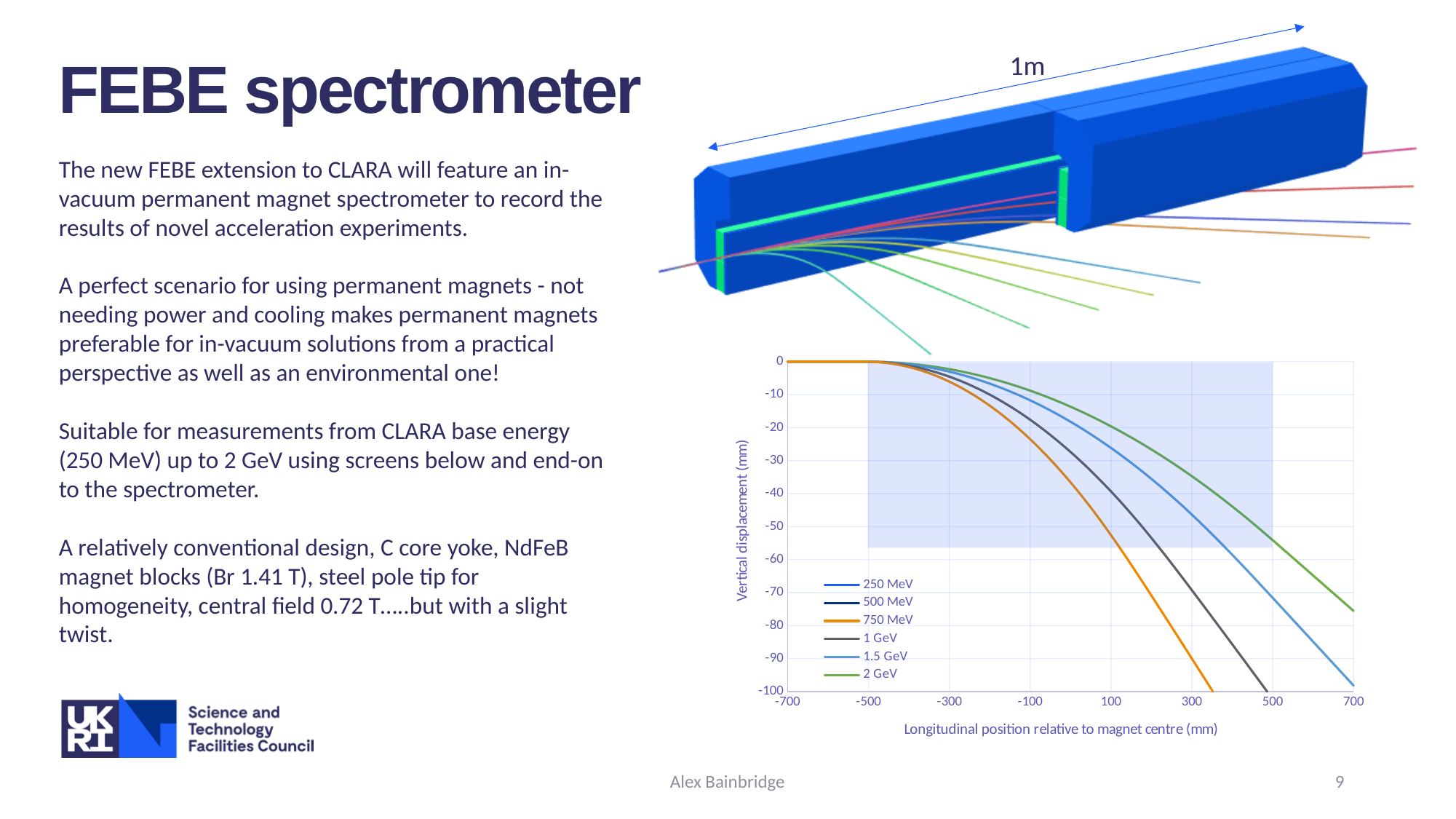
Which curve reaches a vertical displacement of -100 mm at the smallest longitudinal position? 750 MeV What kind of chart is shown on the slide? line chart Do the vertical displacement values rise or fall as longitudinal position increases along the x axis? fall At a longitudinal position of 500 mm, which curve has the larger (less negative) vertical displacement, 1.5 GeV or 2 GeV? 2 GeV Is the vertical displacement of the 750 MeV curve at 100 mm greater or less than -40? less What is the title of the chart's y axis? Vertical displacement (mm) How many series does the chart legend list? 6 Is the vertical displacement of the 2 GeV curve at 100 mm greater or less than -30? greater What is the vertical displacement of the curves at a longitudinal position of -700 mm? 0 Is the vertical displacement of the 2 GeV curve at 700 mm greater or less than -50? less What is the title of the chart's x axis? Longitudinal position relative to magnet centre (mm) How many tick labels are shown on the chart's x axis? 8